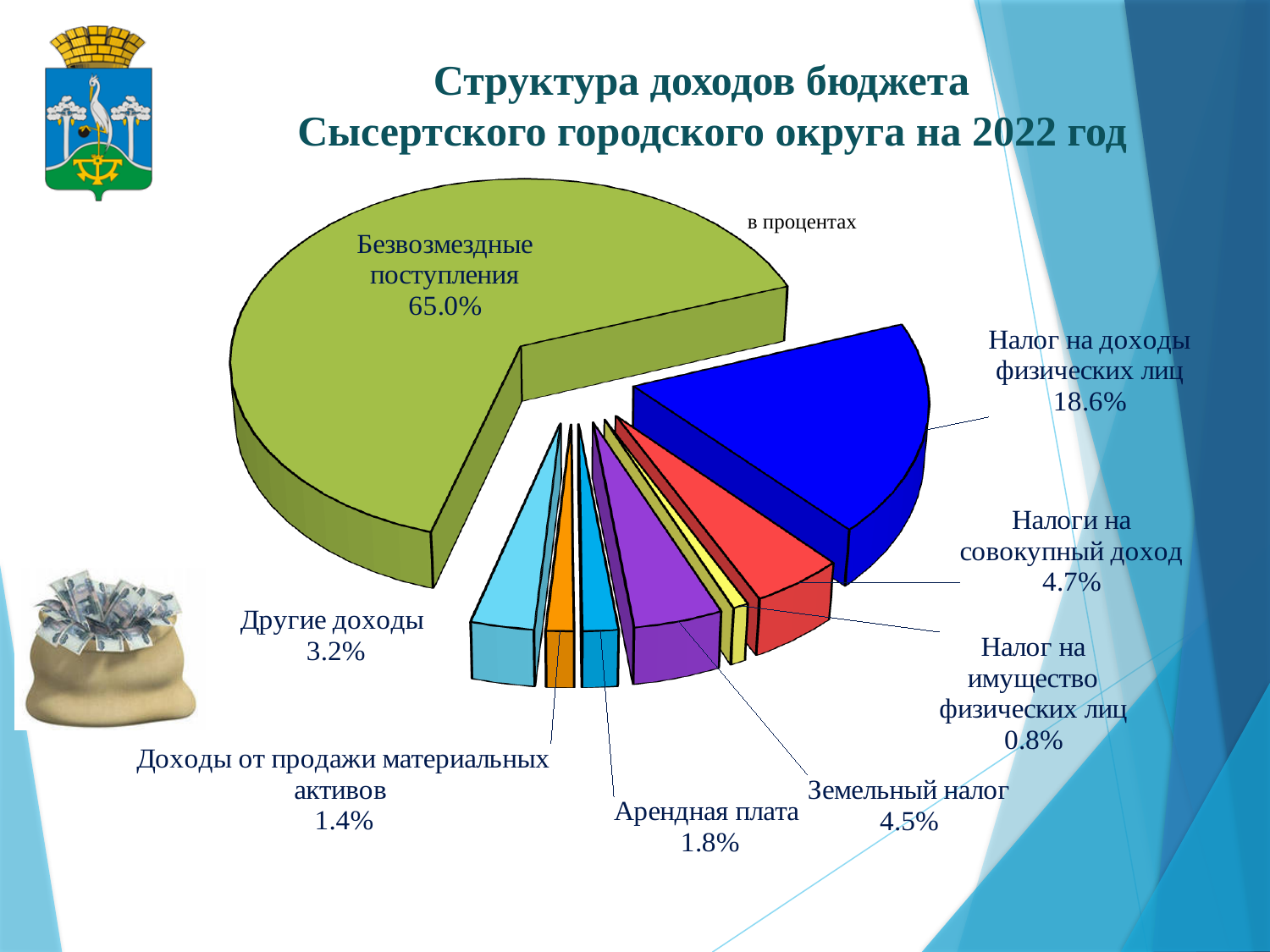
Какова доля земельного налога? 4.5% Какой тип диаграммы показан на слайде? Круговая диаграмма Какова доля безвозмездных поступлений в структуре доходов бюджета? 65.0% Что больше: доля арендной платы или доля других доходов? Другие доходы Какая категория доходов имеет наименьшую долю? Налог на имущество физических лиц Какая категория доходов имеет наибольшую долю? Безвозмездные поступления Что больше: доля налогов на совокупный доход или доля земельного налога? Налоги на совокупный доход Какова доля доходов от продажи материальных активов? 1.4% Какова доля налога на доходы физических лиц? 18.6% Сколько категорий доходов показано на диаграмме? 8 В каких единицах представлены данные на диаграмме? В процентах На сколько процентных пунктов доля безвозмездных поступлений больше доли налога на доходы физических лиц? 46.4